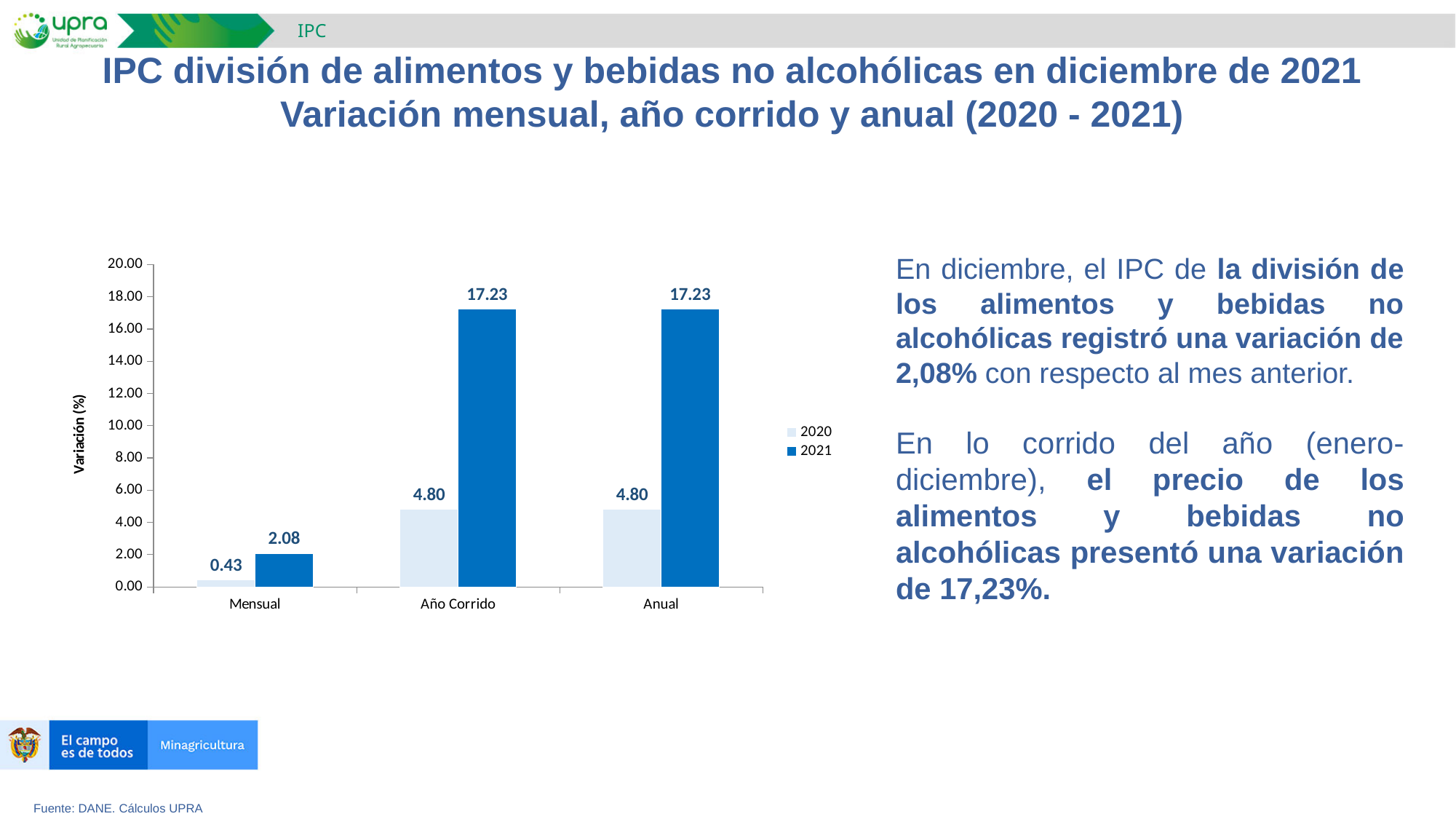
What is the difference between the 2021 and 2020 values for Año Corrido? 12.43 How many series does the legend list? 2 Which category has the lowest 2021 value? Mensual What is the label of the y axis? Variación (%) Which is larger, the 2020 value for Anual or the 2021 value for Mensual? 2020 value for Anual What kind of chart is shown on the slide? Bar chart What is the 2020 value for Mensual? 0.43 What is the 2020 value for Año Corrido? 4.80 How many categories are shown on the x axis? 3 What is the difference between the 2021 and 2020 values for Mensual? 1.65 What is the 2021 value for Mensual? 2.08 What is the 2021 value for Anual? 17.23